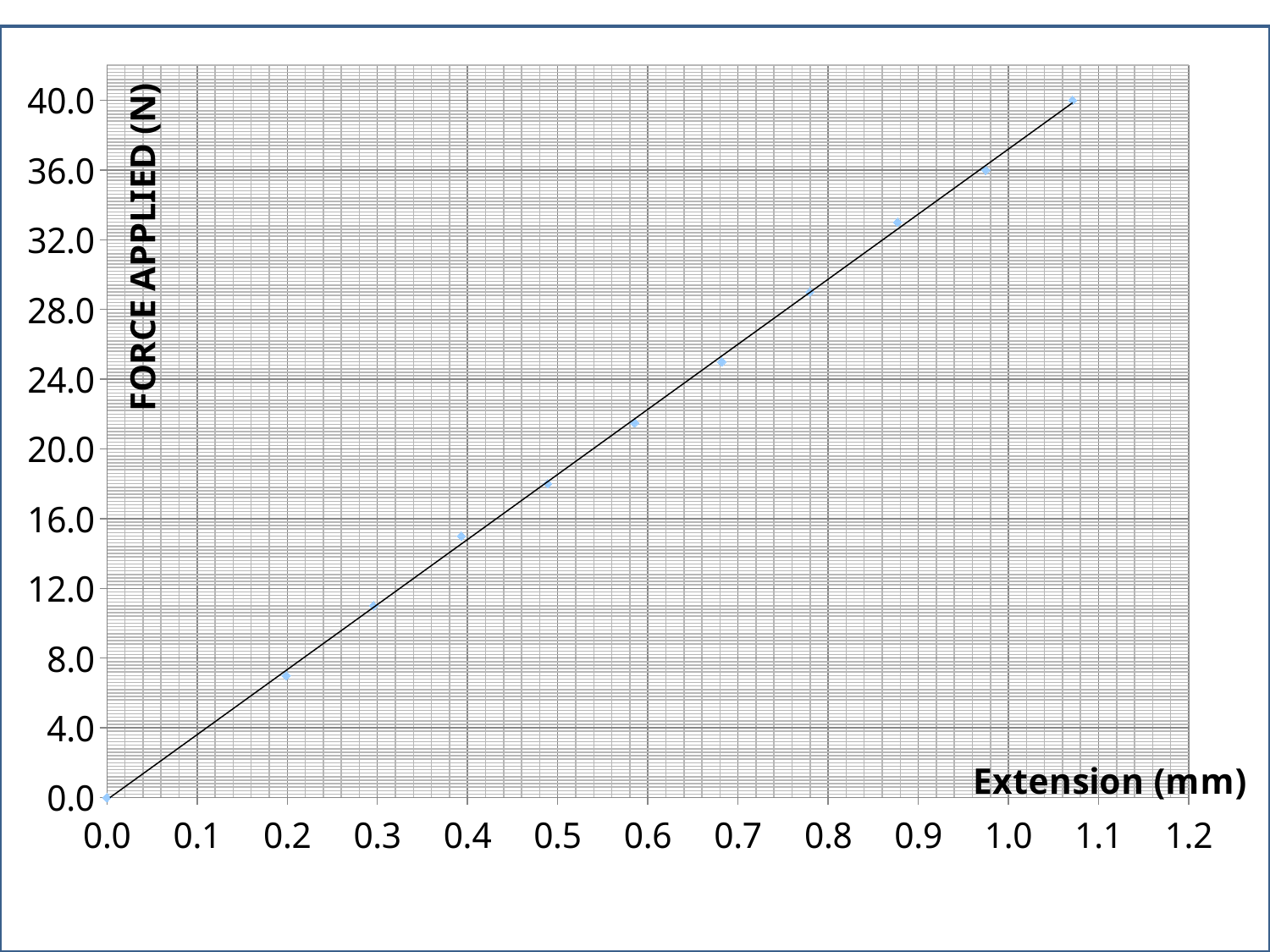
Do the plotted force values rise or fall as extension increases along the x axis? Rise Which of the two data points has the larger force value: the one nearest an extension of 0.4 mm or the one nearest 0.9 mm? The one nearest 0.9 mm Is the force value for the data point nearest an extension of 0.8 mm greater or less than 28.0? greater What kind of chart is shown on the slide? Scatter chart with a trend line Is the force value for the data point nearest an extension of 0.6 mm greater or less than 20.0? greater Is the force value for the data point nearest an extension of 0.3 mm greater or less than 12.0? less What is the title of the vertical axis? FORCE APPLIED (N) What is the title of the horizontal axis? Extension (mm) How many data points are plotted on the chart? 11